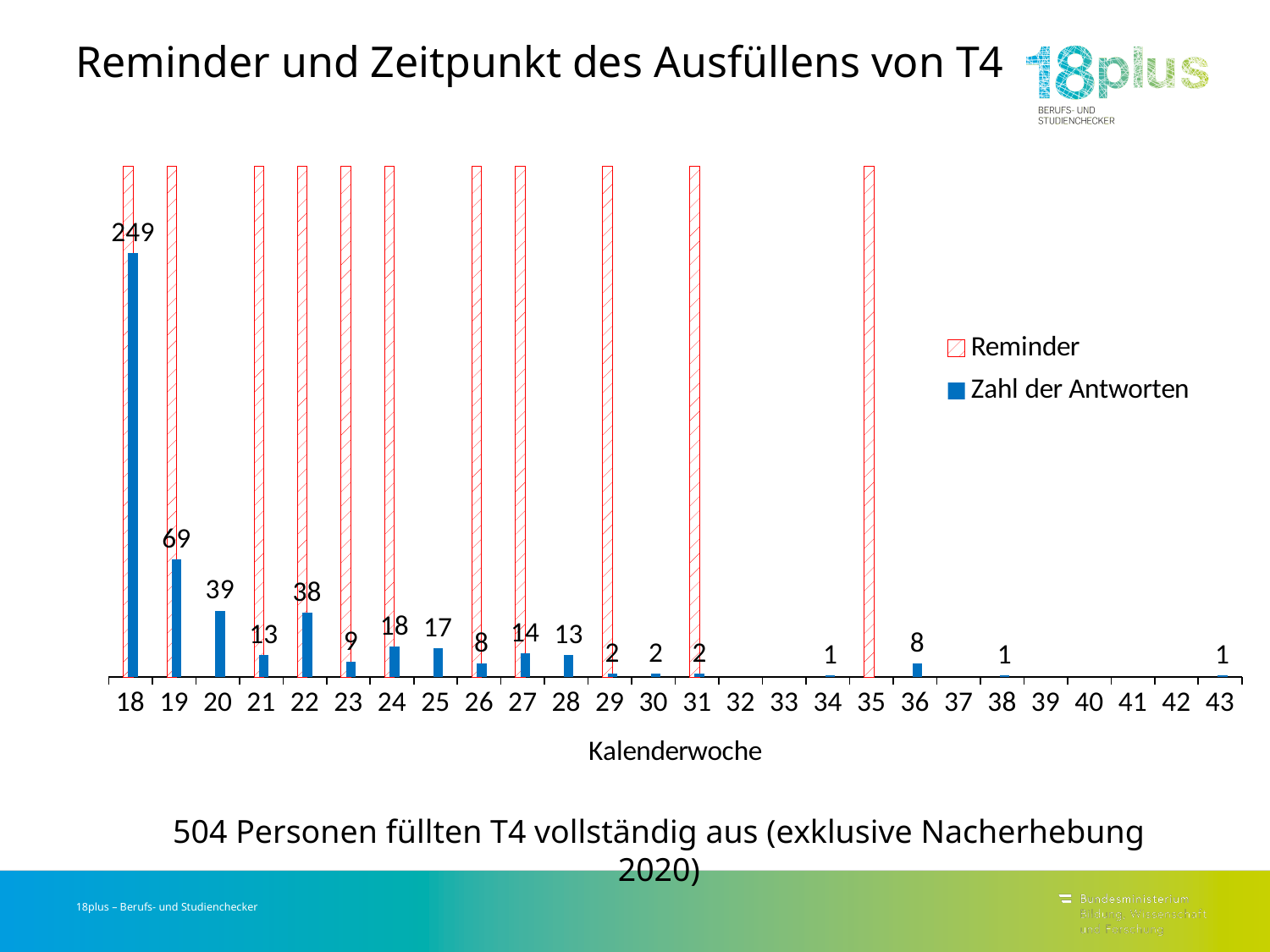
What is the value of Zahl der Antworten for Kalenderwoche 36? 8 What is the label of the x axis? Kalenderwoche How many Kalenderwochen are shown on the x axis? 26 How many series does the legend list? 2 What kind of chart is shown on the slide? bar chart What is the value of Zahl der Antworten for Kalenderwoche 22? 38 Which has a larger Zahl der Antworten, Kalenderwoche 24 or Kalenderwoche 25? Kalenderwoche 24 Does Zahl der Antworten generally rise or fall from Kalenderwoche 18 to Kalenderwoche 43? fall Which Kalenderwoche has the highest Zahl der Antworten? 18 What is the difference between Zahl der Antworten for Kalenderwoche 18 and Kalenderwoche 19? 180 What is the difference between Zahl der Antworten for Kalenderwoche 20 and Kalenderwoche 22? 1 What is the value of Zahl der Antworten for Kalenderwoche 18? 249